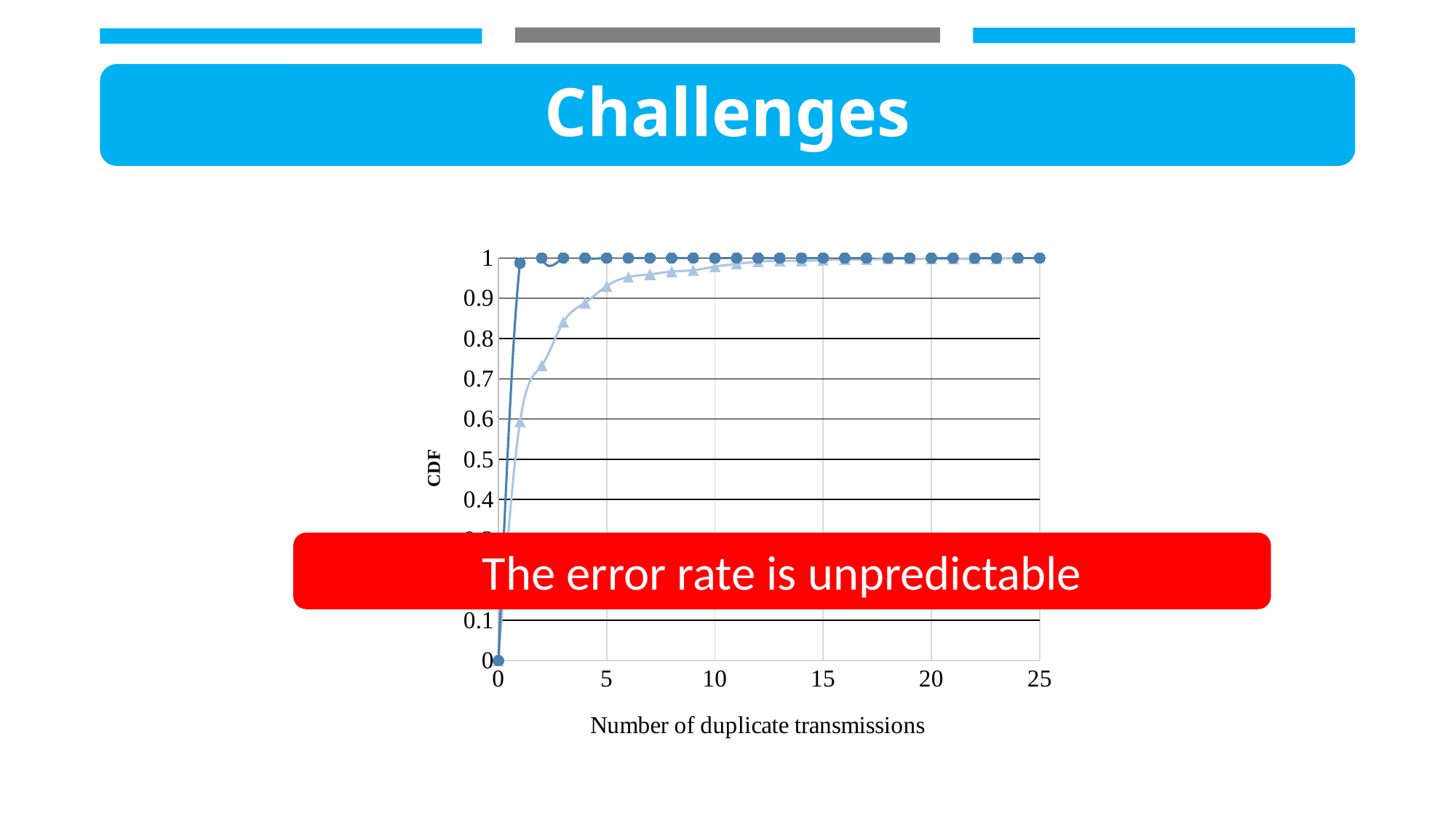
What is the value of the circle-marker series at 0 duplicate transmissions? 0 At 1 duplicate transmission, which series has the higher CDF value, the circle-marker series or the triangle-marker series? circle-marker series What is the value of the circle-marker series at 25 duplicate transmissions? 1 Is the value of the triangle-marker series at 1 duplicate transmission greater or less than 0.5? greater Do the CDF values rise or fall as the number of duplicate transmissions increases? rise What is the title of the y axis of the chart? CDF Is the value of the circle-marker series at 1 duplicate transmission greater or less than 0.9? greater Is the value of the triangle-marker series at 5 duplicate transmissions greater or less than 0.8? greater What is the title of the x axis of the chart? Number of duplicate transmissions What kind of chart is shown on the slide? line chart How many lines (series) are plotted on the chart? 2